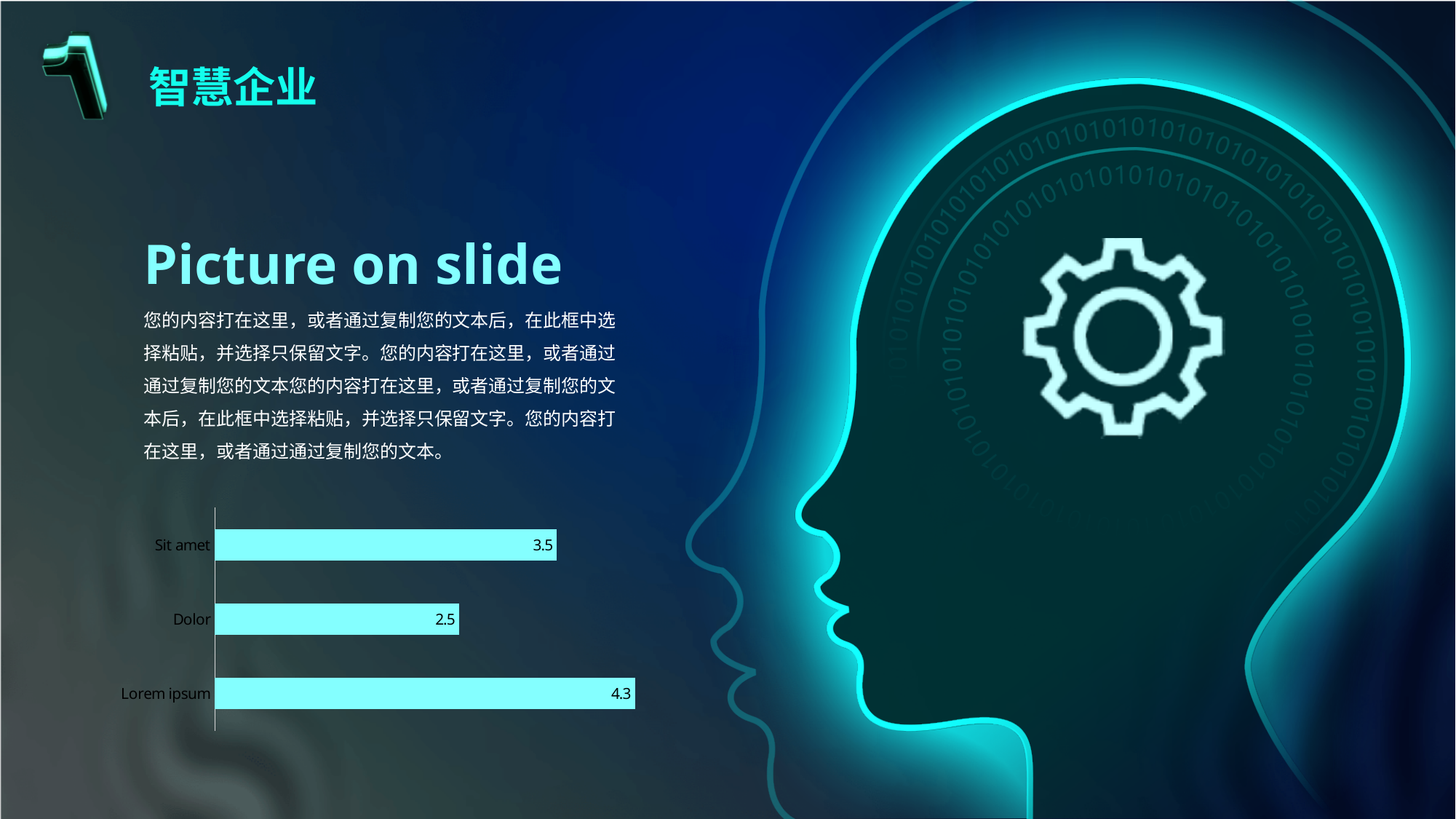
Which category has the lowest value? Dolor Which category has the highest value? Lorem ipsum What is the value for Dolor? 2.5 What colour are the bars in the chart? Cyan What is the value for Lorem ipsum? 4.3 How many categories are shown in the chart? 3 What kind of chart is shown on the slide? Bar chart What is the value for Sit amet? 3.5 Which is larger, the value for Dolor or the value for Lorem ipsum? Lorem ipsum Which is larger, the value for Sit amet or the value for Dolor? Sit amet What is the difference between the values for Lorem ipsum and Sit amet? 0.8 What is the difference between the values for Sit amet and Dolor? 1